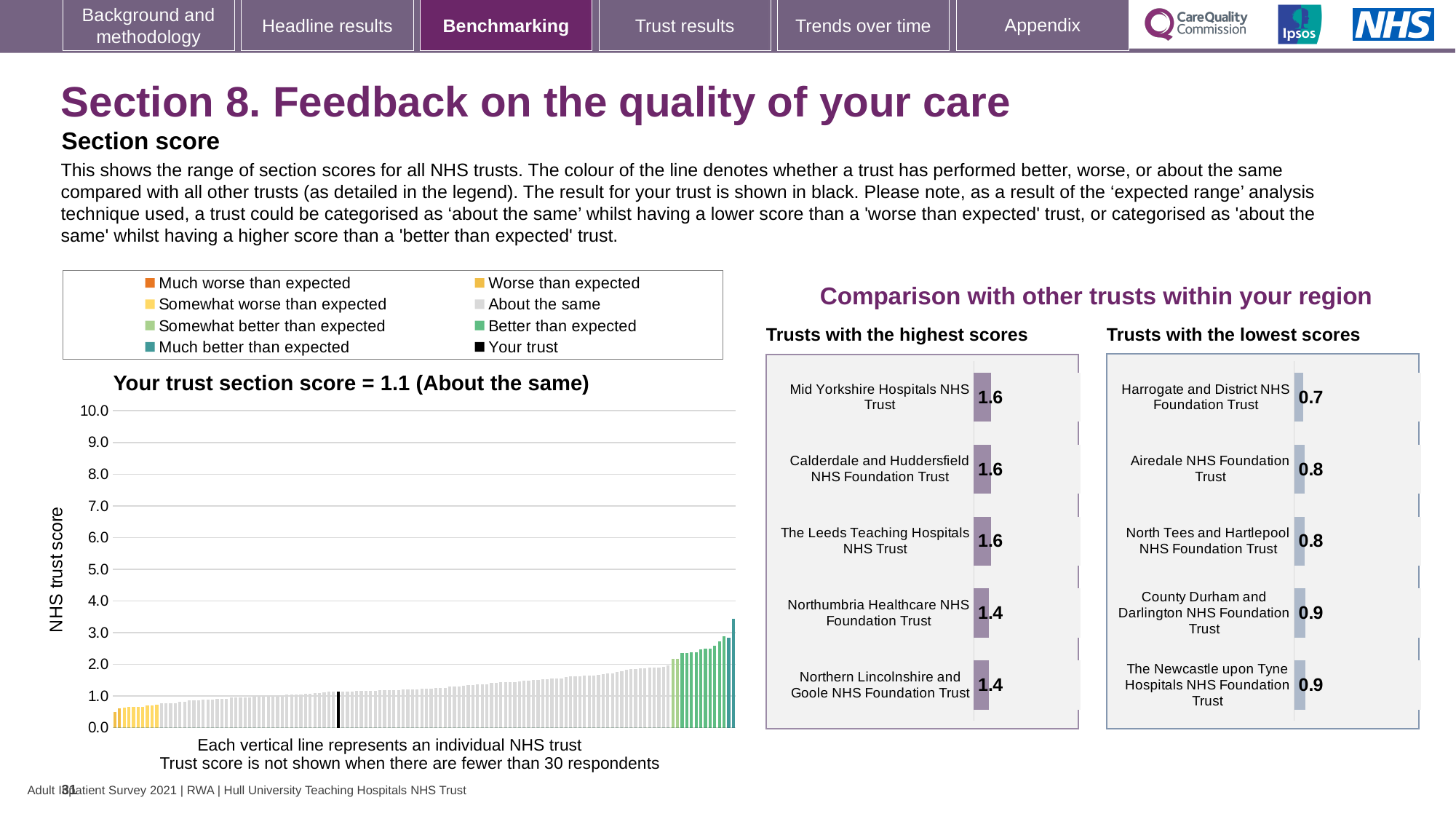
In the 'Your trust section score' chart, what is the label on the vertical axis? NHS trust score In the 'Trusts with the highest scores' chart, what is the score for Mid Yorkshire Hospitals NHS Trust? 1.6 In the 'Trusts with the highest scores' chart, which has the higher score: The Leeds Teaching Hospitals NHS Trust or Northern Lincolnshire and Goole NHS Foundation Trust? The Leeds Teaching Hospitals NHS Trust In the 'Trusts with the lowest scores' chart, what is the difference between the scores of The Newcastle upon Tyne Hospitals NHS Foundation Trust and Harrogate and District NHS Foundation Trust? 0.2 In the 'Trusts with the lowest scores' chart, which trust has the lowest score? Harrogate and District NHS Foundation Trust In the 'Trusts with the highest scores' chart, what is the score for Northumbria Healthcare NHS Foundation Trust? 1.4 In the 'Trusts with the highest scores' chart, how many trusts are shown? 5 In the 'Your trust section score' chart, is the value of the tallest bar greater or less than 4.0? less In the 'Your trust section score' chart, what is the section score for your trust? 1.1 How many entries does the legend above the 'Your trust section score' chart list? 8 In the 'Trusts with the lowest scores' chart, what is the score for Airedale NHS Foundation Trust? 0.8 What kind of chart is the 'Your trust section score' chart? bar chart